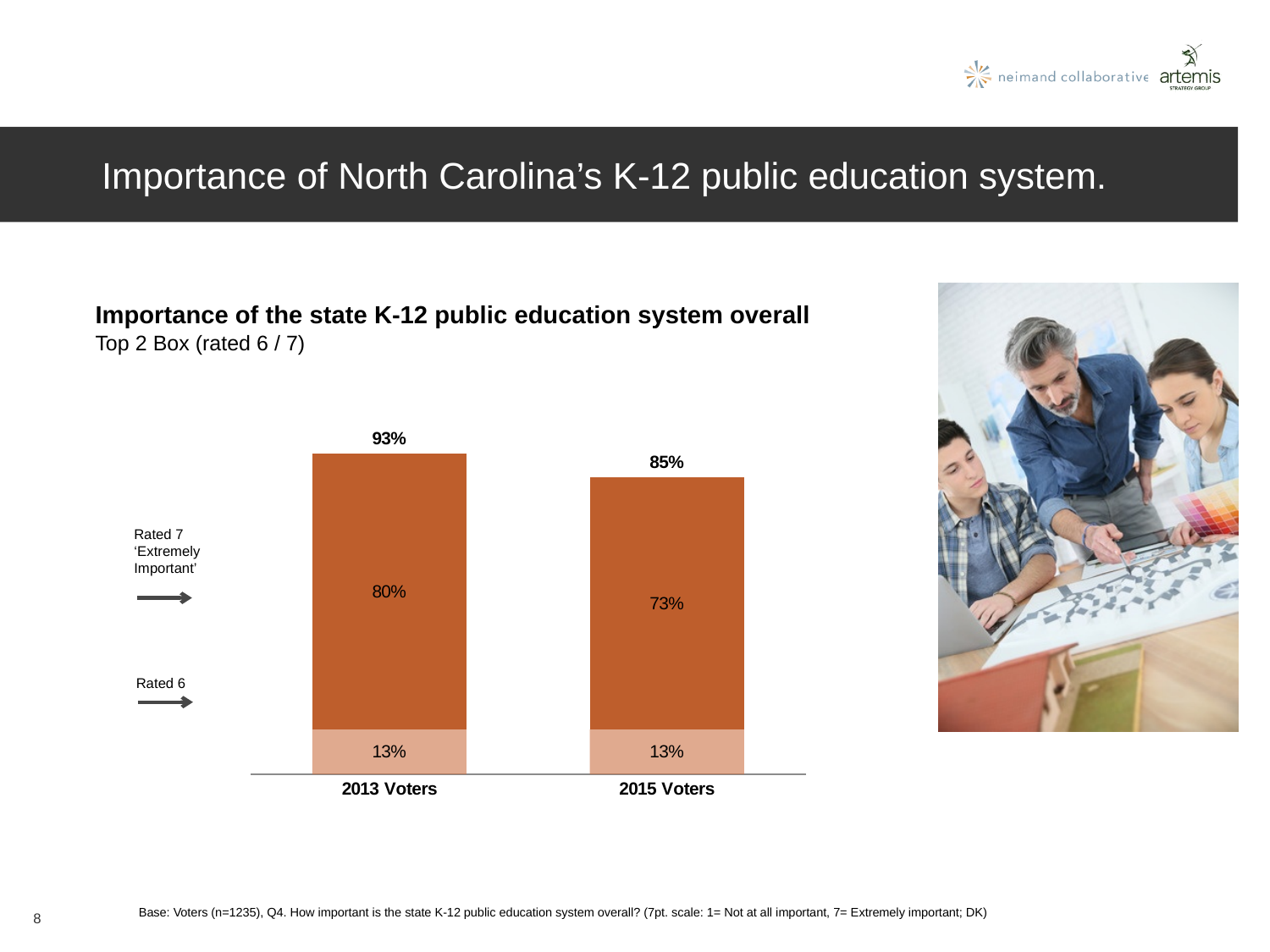
What is the Top 2 Box total shown above the 2013 Voters bar? 93% How many voter groups are shown on the x axis of the chart? 2 What percentage of 2015 Voters rated the system a 6? 13% What kind of chart is used to show the importance ratings? Stacked bar chart Does the Top 2 Box total rise or fall from 2013 Voters to 2015 Voters? Fall Which group has the higher Top 2 Box total, 2013 Voters or 2015 Voters? 2013 Voters By how many percentage points did the 'Rated 7' share fall from 2013 Voters to 2015 Voters? 7 percentage points What percentage of 2013 Voters rated the state K-12 public education system a 7 ('Extremely Important')? 80% What is the difference between the Top 2 Box totals for 2013 Voters and 2015 Voters? 8 percentage points What percentage of 2015 Voters rated the state K-12 public education system a 7 ('Extremely Important')? 73% What is the Top 2 Box total shown above the 2015 Voters bar? 85% Is the 'Rated 7' value larger for 2013 Voters or 2015 Voters? 2013 Voters